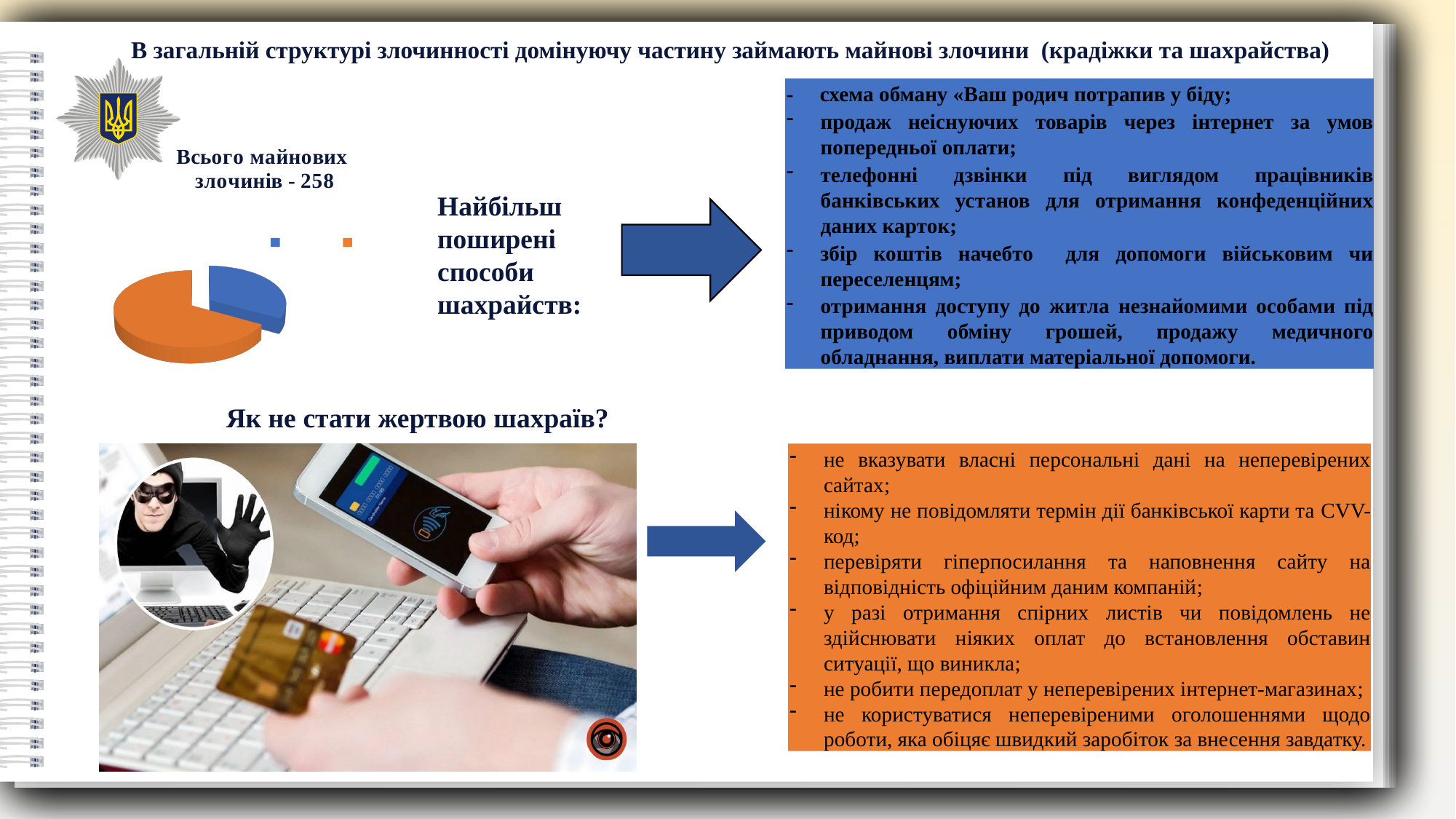
How many slices does the pie chart have? 2 What total number of property crimes is stated in the pie chart's title? 258 Which slice of the pie chart is larger, the blue one or the orange one? the orange one Which slice of the pie chart is the largest? the orange slice What kind of chart is shown on the slide? pie chart How many entries does the legend of the pie chart list? 2 What is the title shown above the pie chart? Всього майнових злочинів - 258 Which slice of the pie chart is the smallest? the blue slice